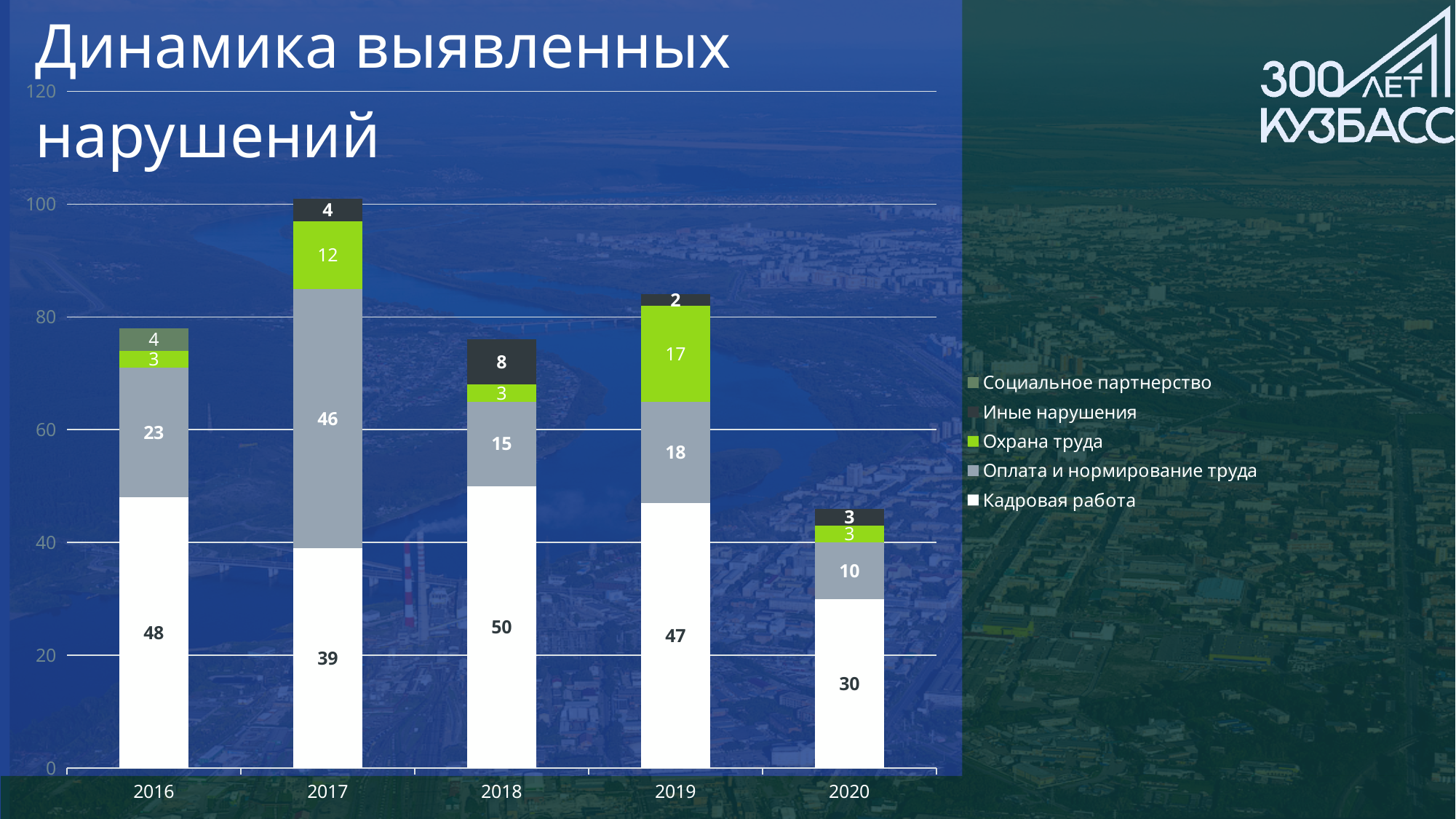
What is the difference between the Кадровая работа values for 2018 and 2020? 20 In which year is the Оплата и нормирование труда value the highest? 2017 What kind of chart is shown on the slide? Stacked bar chart What is the value for Кадровая работа in 2018? 50 What is the total of the stacked bar for 2020? 46 In which year is the Кадровая работа value the lowest? 2020 How many series does the legend list? 5 Is the total of the stacked bar for 2017 greater or less than 100? greater Which is larger, the Охрана труда value in 2017 or in 2019? 2019 What is the value for Охрана труда in 2019? 17 What is the value for Оплата и нормирование труда in 2017? 46 How many years are shown on the x axis? 5